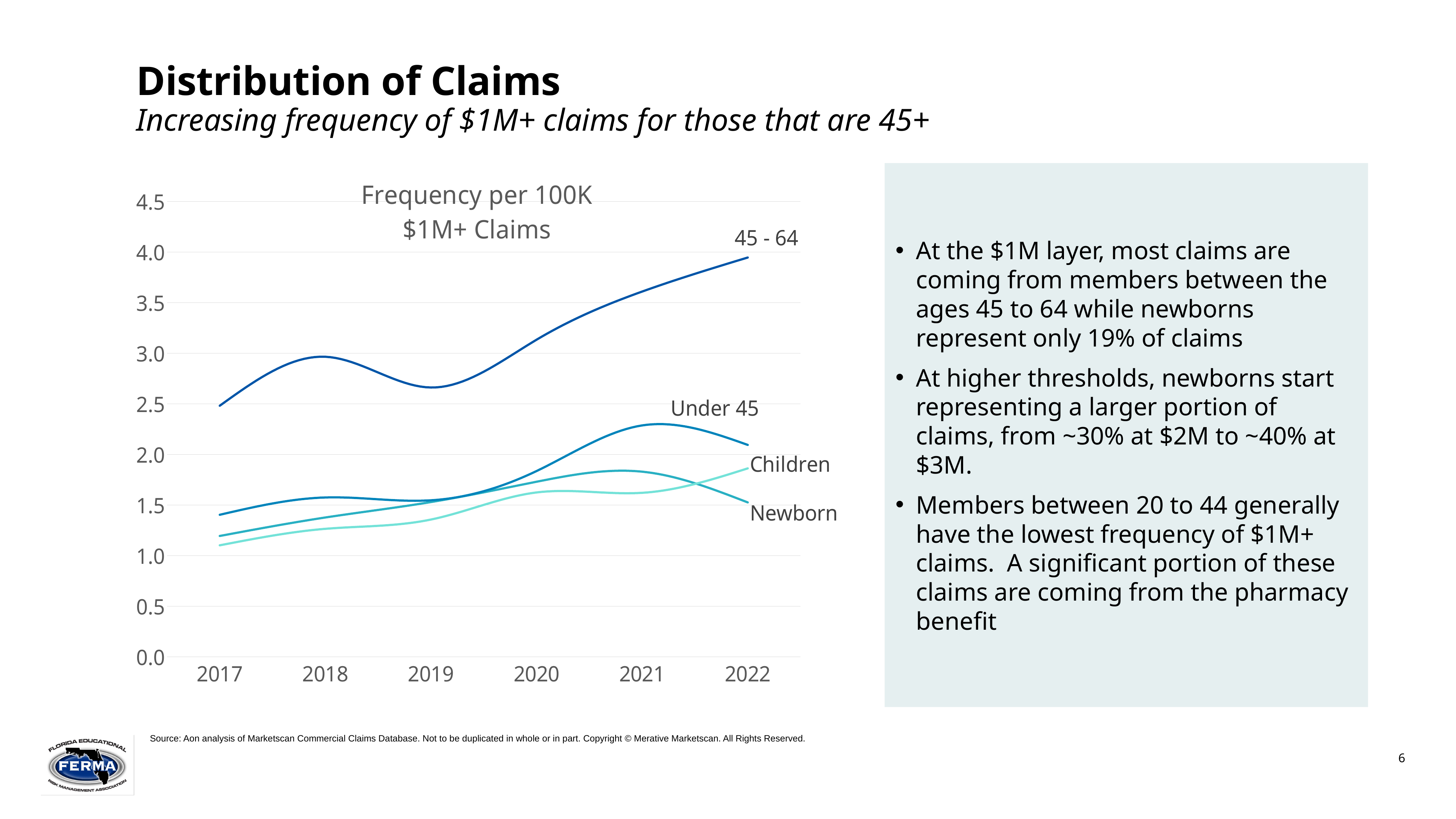
Which age group has the lowest frequency per 100K in 2017? Children Is the value for 45 - 64 in 2022 greater or less than 3.5? greater What kind of chart is shown on the slide? Line chart In 2022, which is higher: Children or Newborn? Children How many years are shown on the x axis of the chart? 6 How many series (age groups) are plotted on the chart? 4 What is the title of the chart? Frequency per 100K $1M+ Claims Is the value for Under 45 in 2021 greater or less than 2.0? greater Is the value for 45 - 64 in 2017 greater or less than 3.0? less Does the 45 - 64 line rise or fall from 2019 to 2022? Rise Which age group has the highest frequency per 100K in 2022? 45 - 64